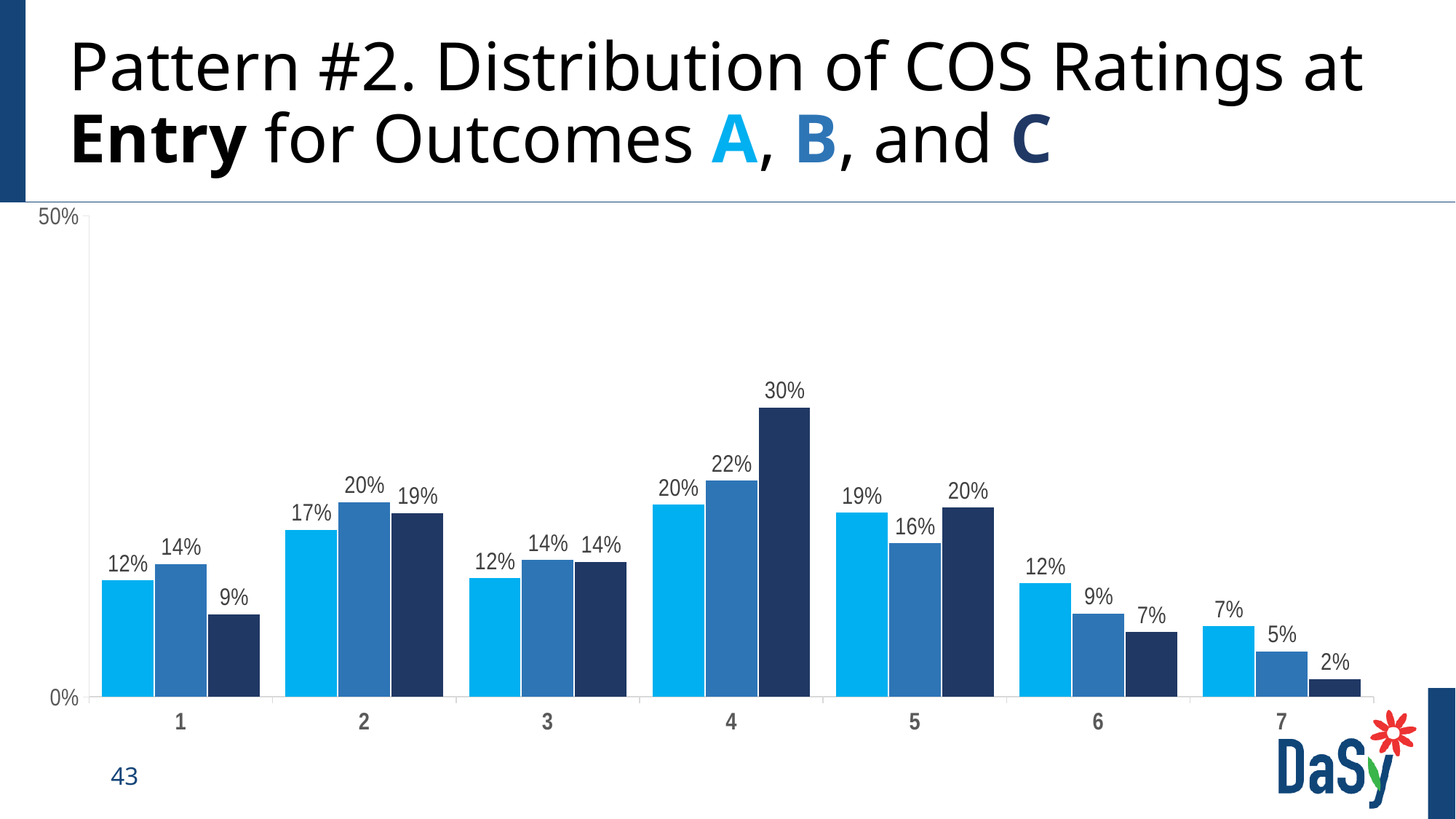
How many COS rating categories are shown on the x axis? 7 Which rating has the lowest value for Outcome A (light blue bars)? 7 What is the difference between the Outcome C value and the Outcome A value at rating 4? 10% What is the value for Outcome C (dark navy bars) at rating 4? 30% What type of chart is shown on the slide? bar chart What is the value for Outcome A (light blue bars) at rating 2? 17% What is the value for Outcome C (dark navy bars) at rating 7? 2% At rating 6, which is larger: the value for Outcome A or the value for Outcome C? Outcome A What is the value for Outcome B (medium blue bars) at rating 7? 5% Which rating has the highest value for Outcome C (dark navy bars)? 4 What is the difference between the Outcome B value at rating 1 and the Outcome C value at rating 1? 5% What is the maximum value shown on the y axis? 50%